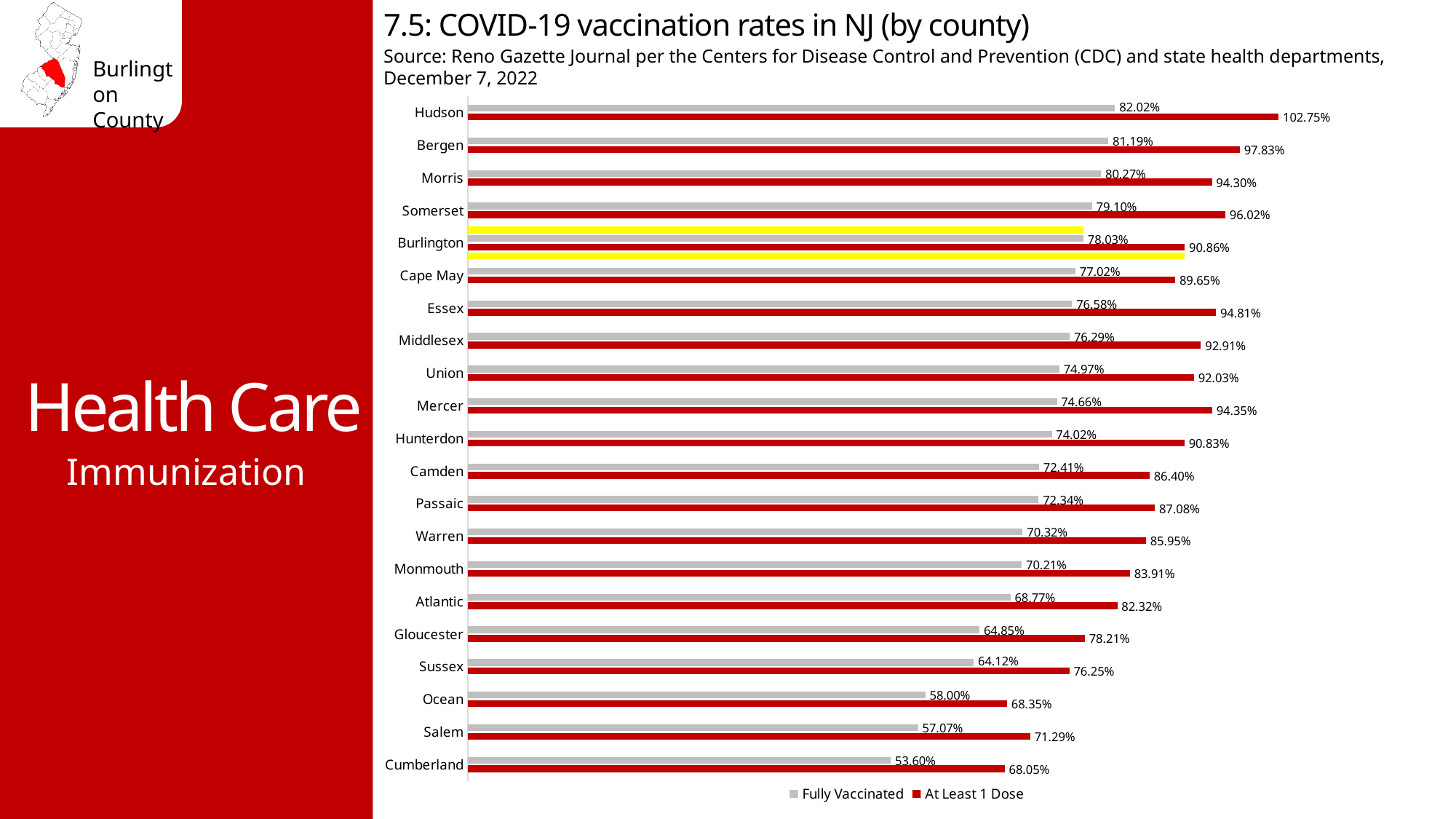
Which county's bars are highlighted in yellow on the chart? Burlington Which county has the lowest Fully Vaccinated rate? Cumberland Which county has the highest Fully Vaccinated rate? Hudson What is the difference between the At Least 1 Dose rate and the Fully Vaccinated rate for Burlington county? 12.83% What is the difference between the Fully Vaccinated rates of Hudson and Cumberland counties? 28.42% What is the Fully Vaccinated rate for Burlington county? 78.03% How many counties are shown in the chart? 21 What is the At Least 1 Dose rate for Hudson county? 102.75% What is the At Least 1 Dose rate for Cape May county? 89.65% What kind of chart is shown on the slide? Bar chart Which county has the larger Fully Vaccinated rate, Camden or Gloucester? Camden How many series does the legend list? 2